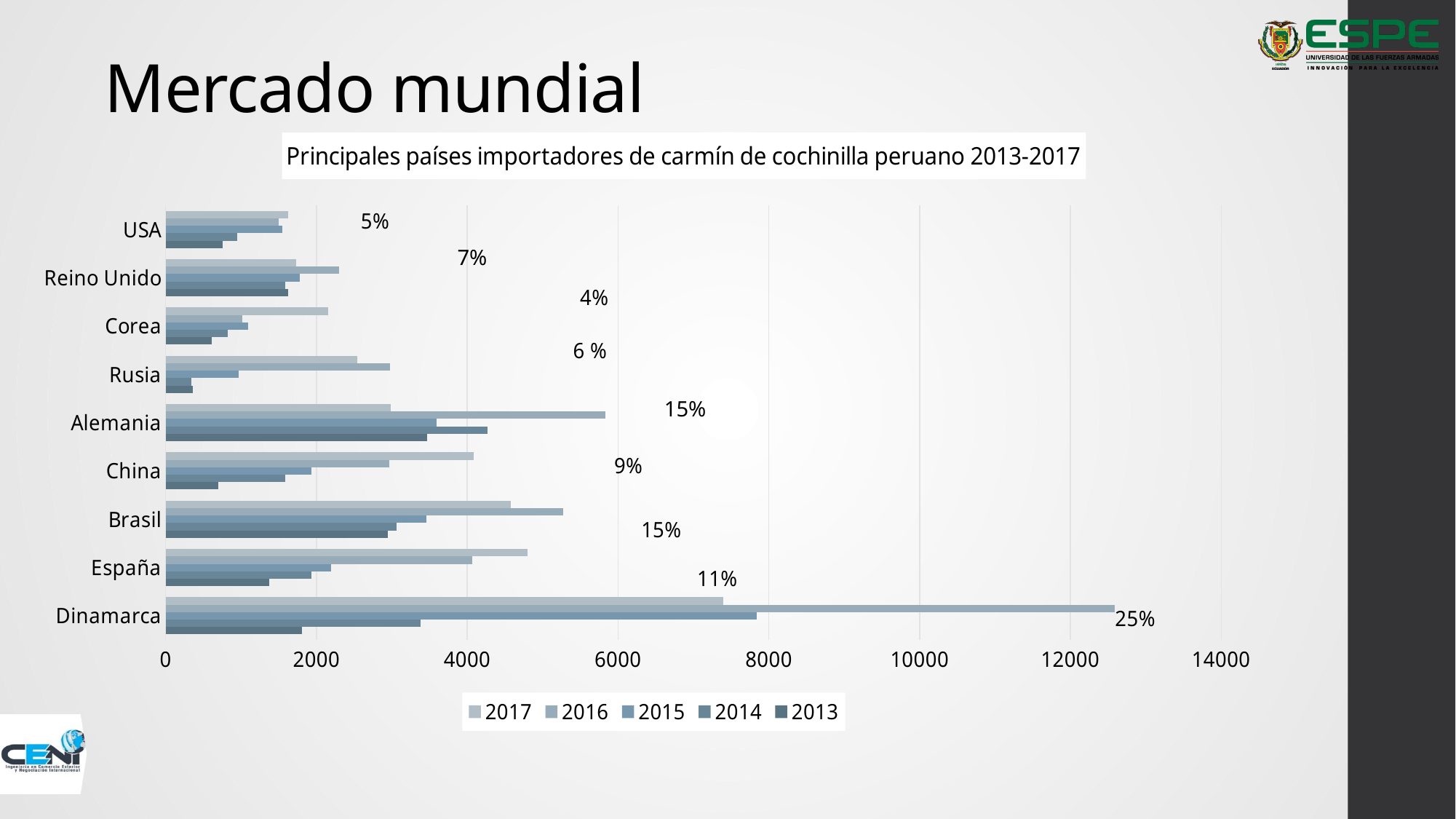
Is the 2016 value for Dinamarca greater or less than 12000? greater What is the title of the chart? Principales países importadores de carmín de cochinilla peruano 2013-2017 How many series does the legend list? 5 What kind of chart is shown on the slide? bar chart Which is larger, the 2016 value for Dinamarca or the 2016 value for Alemania? Dinamarca What percentage label is printed next to the Dinamarca bars? 25% Is the 2016 value for Alemania greater or less than 6000? less Is the 2013 value for Rusia greater or less than 2000? less Which is larger, the 2016 value for Brasil or the 2016 value for China? Brasil How many countries are listed on the chart's vertical axis? 9 Which country has the longest bar on the chart? Dinamarca